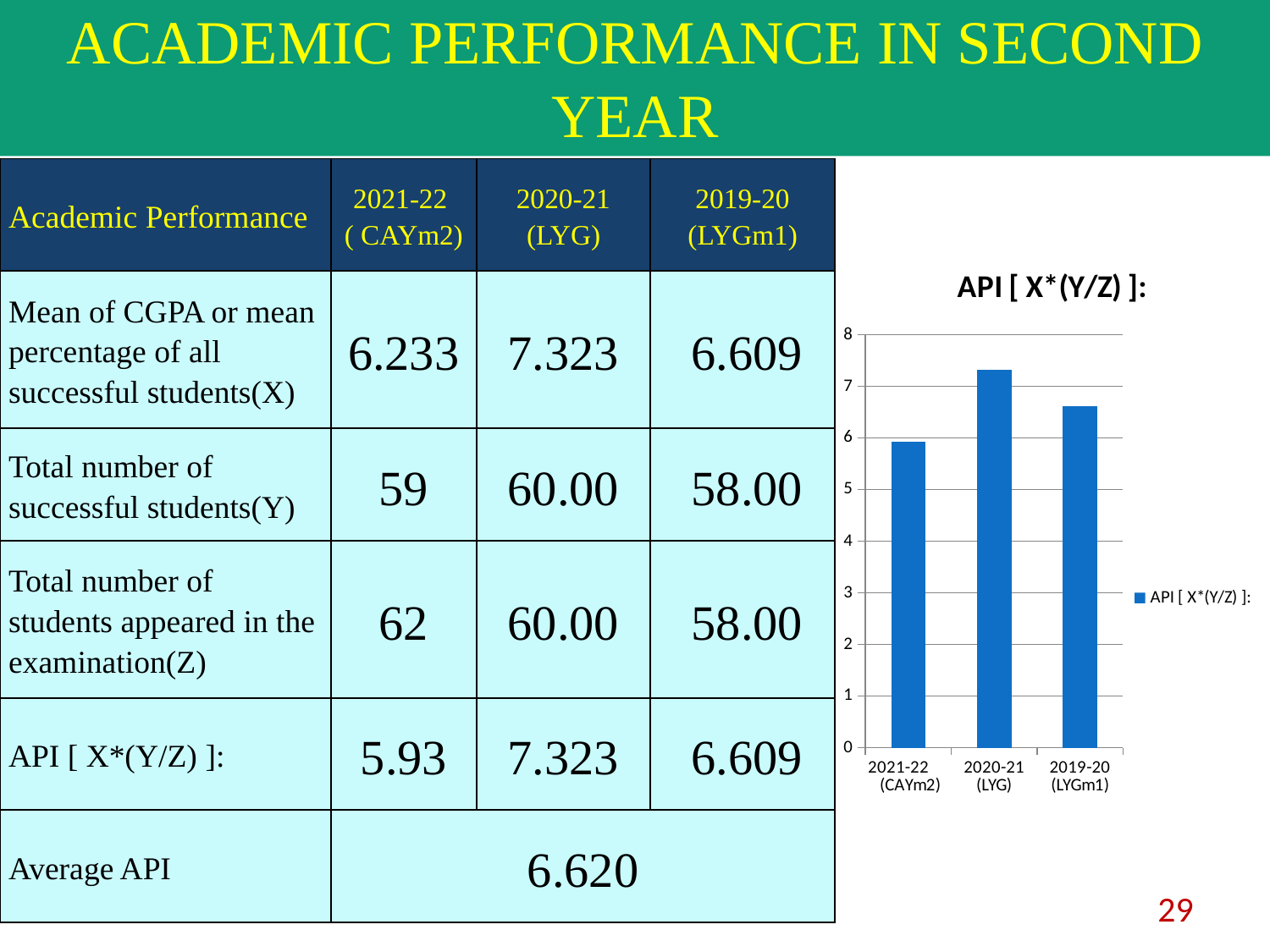
Do the API bars rise or fall from 2021-22 (CAYm2) to 2020-21 (LYG)? rise Is the API value for 2019-20 (LYGm1) greater or less than 6? greater How many series does the chart legend list? 1 Which has the larger API bar, 2020-21 (LYG) or 2019-20 (LYGm1)? 2020-21 (LYG) Is the API value for 2021-22 (CAYm2) greater or less than 6? less Is the API value for 2020-21 (LYG) greater or less than 7? greater What is the title of the chart? API [ X*(Y/Z) ]: What is the API value plotted for 2020-21 (LYG), as given in the table on the slide? 7.323 Which year has the lowest API bar in the chart? 2021-22 (CAYm2) How many bars (categories) does the chart show? 3 What kind of chart is shown on the slide? Bar chart Which year has the highest API bar in the chart? 2020-21 (LYG)